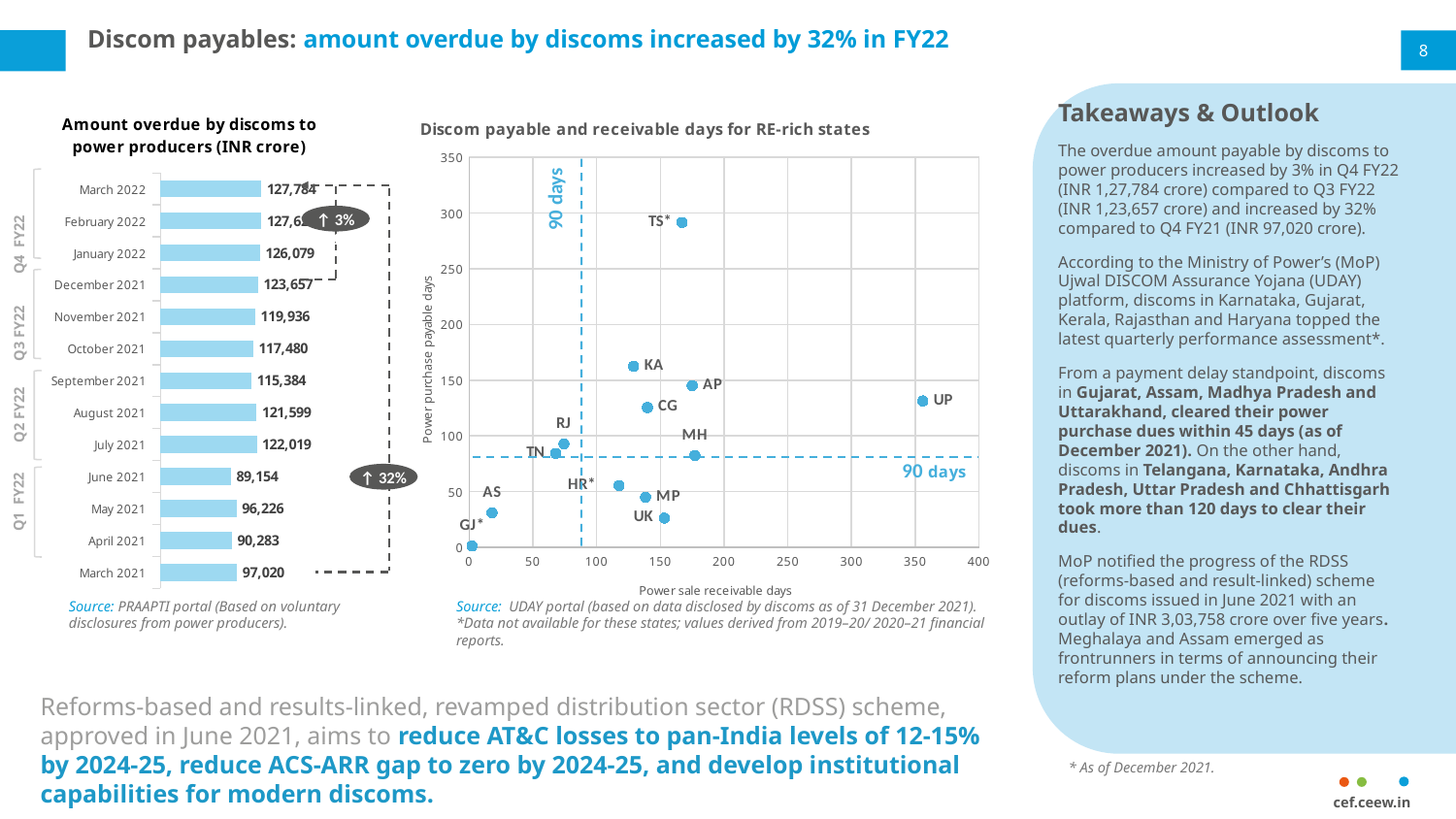
On the 'Amount overdue by discoms to power producers (INR crore)' chart, what is the value for December 2021? 123,657 On the 'Discom payable and receivable days for RE-rich states' chart, is the power purchase payable days value for TS* greater or less than 250? greater On the 'Amount overdue by discoms to power producers (INR crore)' chart, what is the difference between the values for March 2022 and March 2021? 30,764 What kind of chart is 'Amount overdue by discoms to power producers (INR crore)'? Bar chart How many months are shown on the 'Amount overdue by discoms to power producers (INR crore)' chart? 13 On the 'Amount overdue by discoms to power producers (INR crore)' chart, what is the value for March 2021? 97,020 What kind of chart is 'Discom payable and receivable days for RE-rich states'? Scatter chart On the 'Amount overdue by discoms to power producers (INR crore)' chart, which month has the lowest value? June 2021 On the 'Amount overdue by discoms to power producers (INR crore)' chart, which month has the highest value? March 2022 On the 'Amount overdue by discoms to power producers (INR crore)' chart, what is the value for March 2022? 127,784 On the 'Discom payable and receivable days for RE-rich states' chart, is the power sale receivable days value for UP greater or less than 300? greater On the 'Amount overdue by discoms to power producers (INR crore)' chart, which is larger, the value for August 2021 or the value for September 2021? August 2021